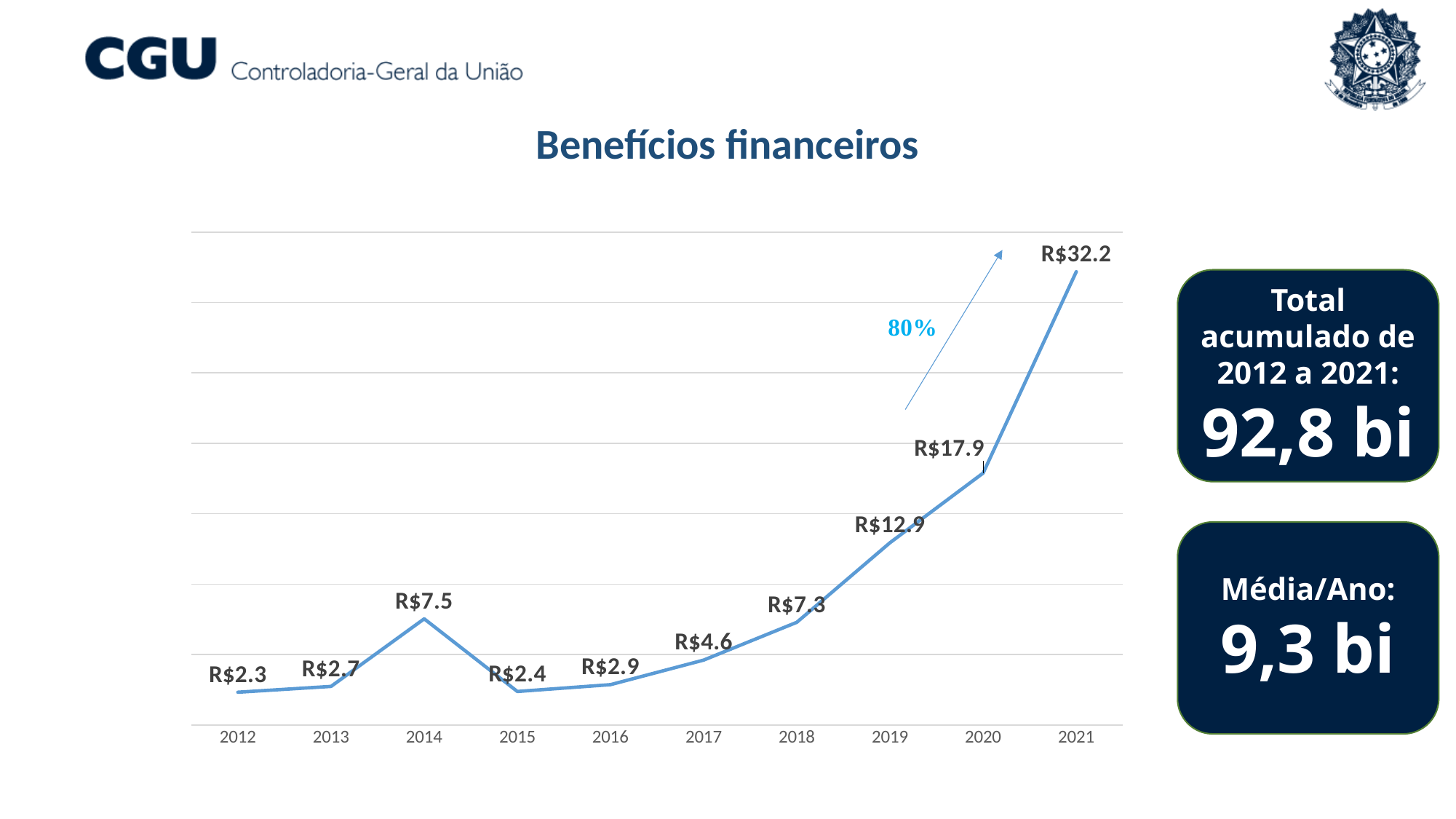
What is the title of the chart? Benefícios financeiros What is the difference between the values for 2021 and 2020? R$14.3 Which is larger, the value for 2014 or the value for 2018? 2014 Which year has the lowest value? 2012 What is the value for 2017? R$4.6 How many years are plotted on the x axis? 10 Do the values rise or fall from 2015 to 2021? Rise What is the value for 2021? R$32.2 Which year has the highest value? 2021 What is the value for 2014? R$7.5 What kind of chart is shown? Line chart What is the difference between the values for 2014 and 2015? R$5.1